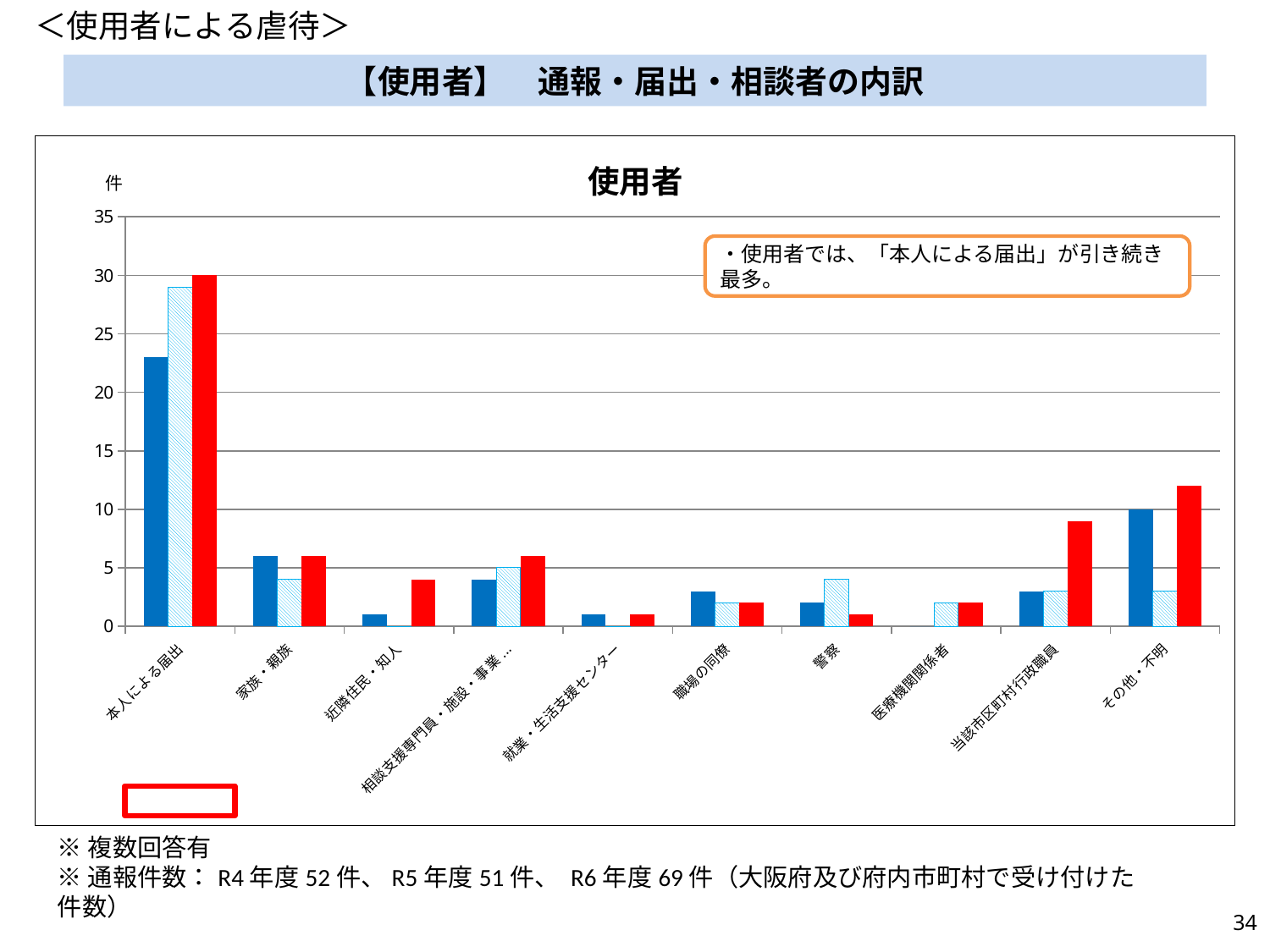
Is the value of the blue bar for 本人による届出 greater or less than 20? greater What unit is shown at the top of the vertical axis? 件 What is the value of the blue bar for その他・不明? 10 What is the value of the red bar for 本人による届出? 30 What is the title of the chart? 使用者 How many categories are shown along the x axis of the chart? 10 How many bars are plotted for each category in the chart? 3 For 当該市区町村行政職員, which is larger, the blue bar or the red bar? the red bar What kind of chart is shown on the slide? bar chart Is the value of the red bar for 当該市区町村行政職員 greater or less than 5? greater Is the value of the red bar for その他・不明 greater or less than 10? greater Which category has the tallest bars in the chart? 本人による届出